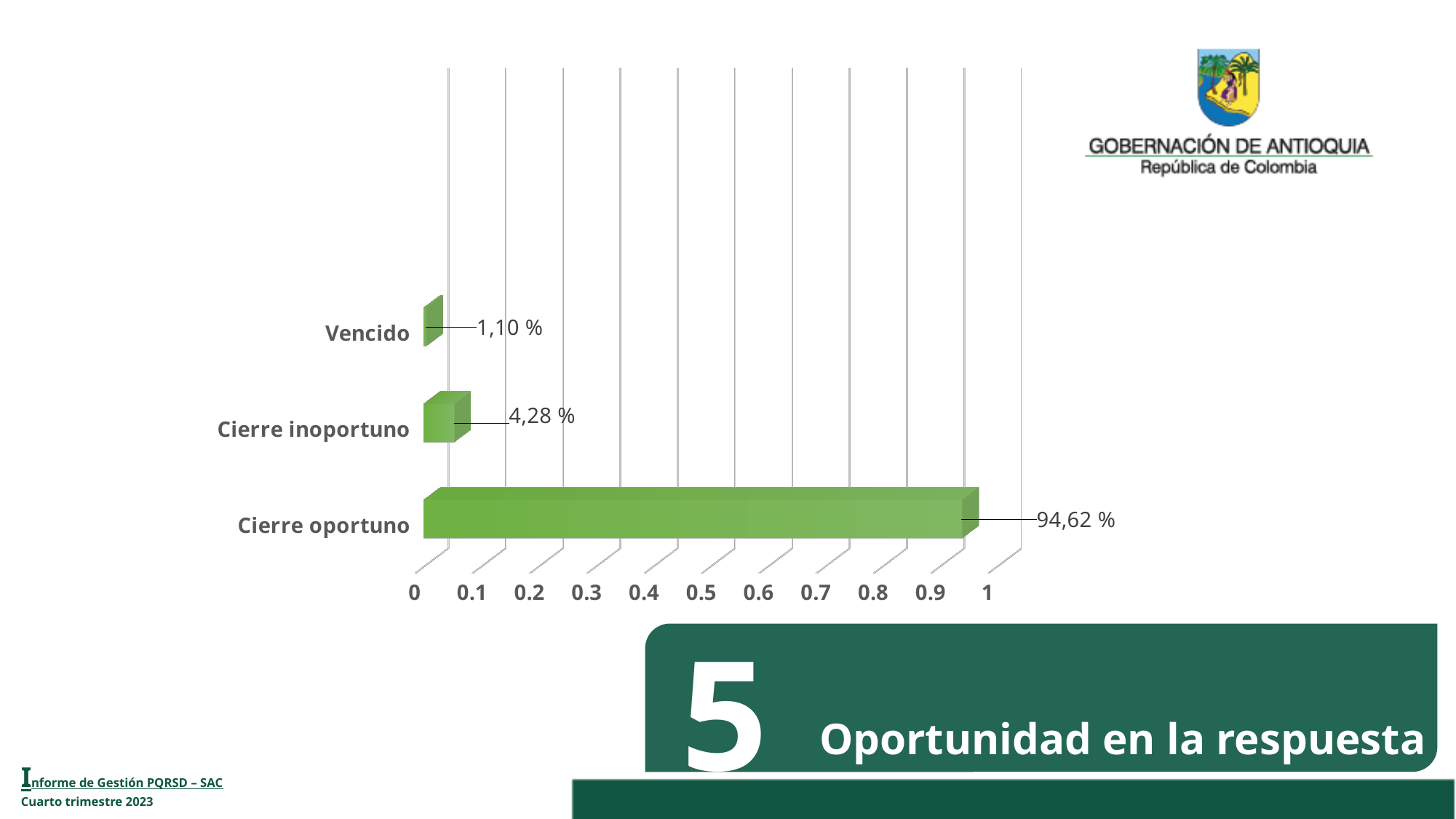
Is the value for Cierre oportuno greater or less than 0.9 on the axis? greater What is the value for Cierre oportuno? 94,62 % How many categories are shown in the chart? 3 What is the difference between the values for Cierre oportuno and Cierre inoportuno? 90,34 % What kind of chart is shown on the slide? Bar chart Which category has the highest value? Cierre oportuno What is the highest tick value shown on the horizontal axis? 1 What is the value for Vencido? 1,10 % Which is larger, the value for Cierre inoportuno or the value for Vencido? Cierre inoportuno Which category has the lowest value? Vencido What is the value for Cierre inoportuno? 4,28 % What is the difference between the values for Cierre inoportuno and Vencido? 3,18 %